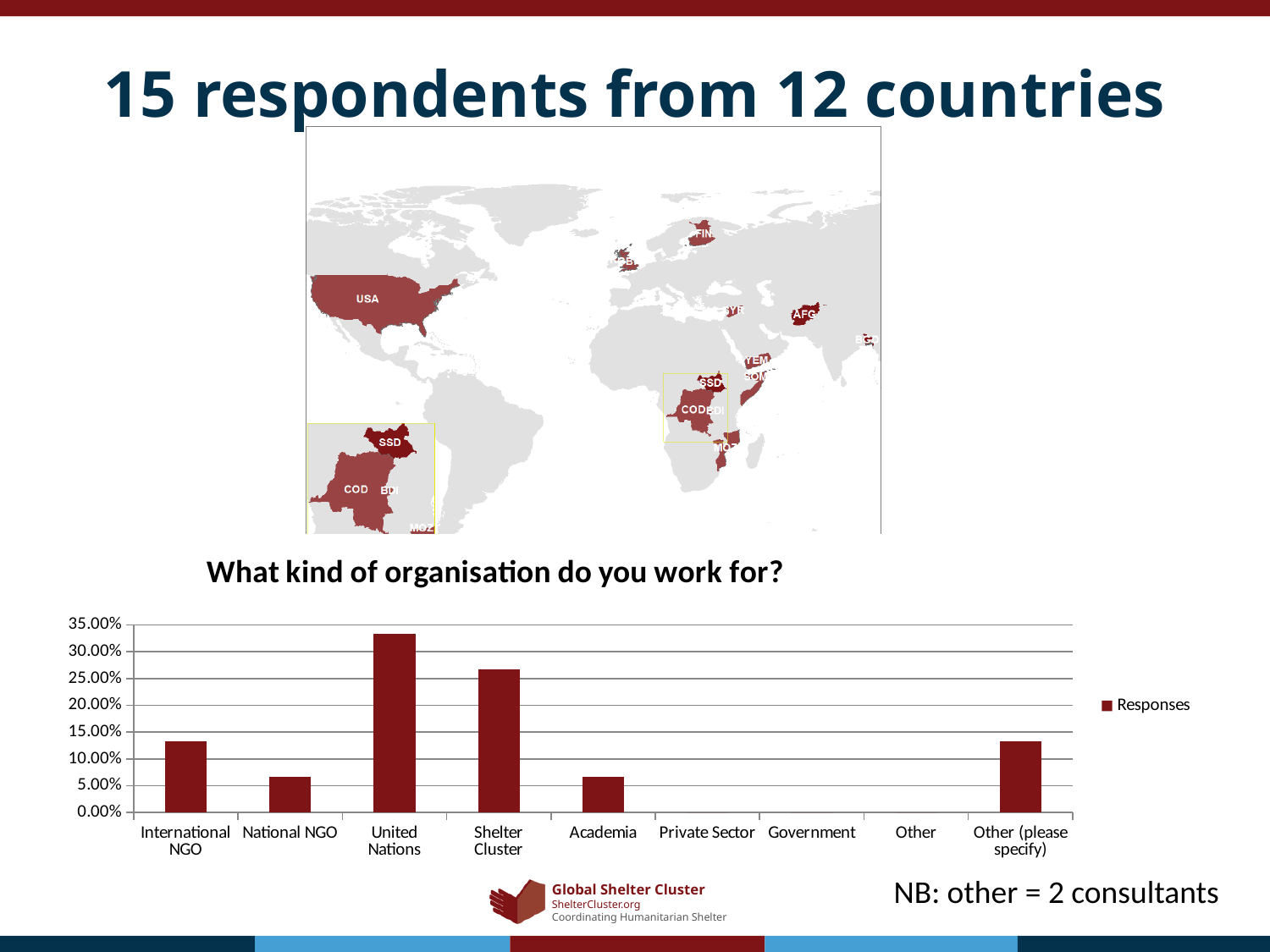
How many series does the chart's legend list? 1 Which is larger, the value for United Nations or the value for Shelter Cluster? United Nations Is the value for Shelter Cluster greater or less than 20.00%? greater What is the name of the series shown in the legend? Responses Which is larger, the value for International NGO or the value for National NGO? International NGO What kind of chart is shown on the slide? bar chart How many categories are shown on the x axis of the chart? 9 What is the title of the chart? What kind of organisation do you work for? Is the value for United Nations greater or less than 30.00%? greater Is the value for International NGO greater or less than 15.00%? less Which category has the highest value in the chart? United Nations